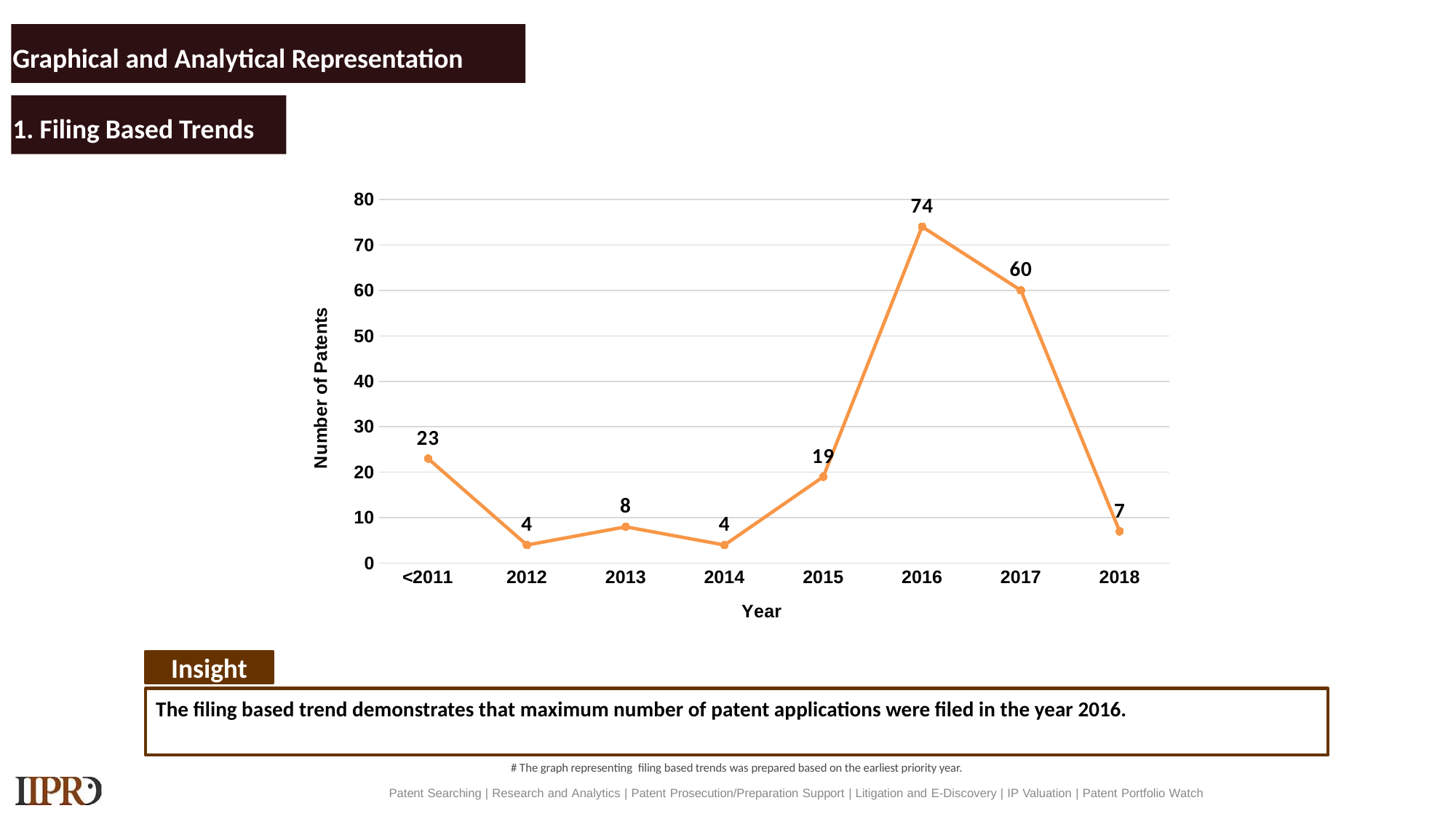
What is the difference in number of patents between 2016 and 2017? 14 How many year categories are shown on the x axis? 8 What is the number of patents for 2018? 7 Do the values rise or fall from 2017 to 2018? fall Is the value for 2017 greater or less than 50? greater Which year has the highest number of patents? 2016 What kind of chart is shown on the slide? line chart What is the number of patents for 2016? 74 What is the difference in number of patents between 2015 and 2013? 11 Which has more patents, 2015 or 2018? 2015 What is the label of the y axis? Number of Patents What is the number of patents for <2011? 23